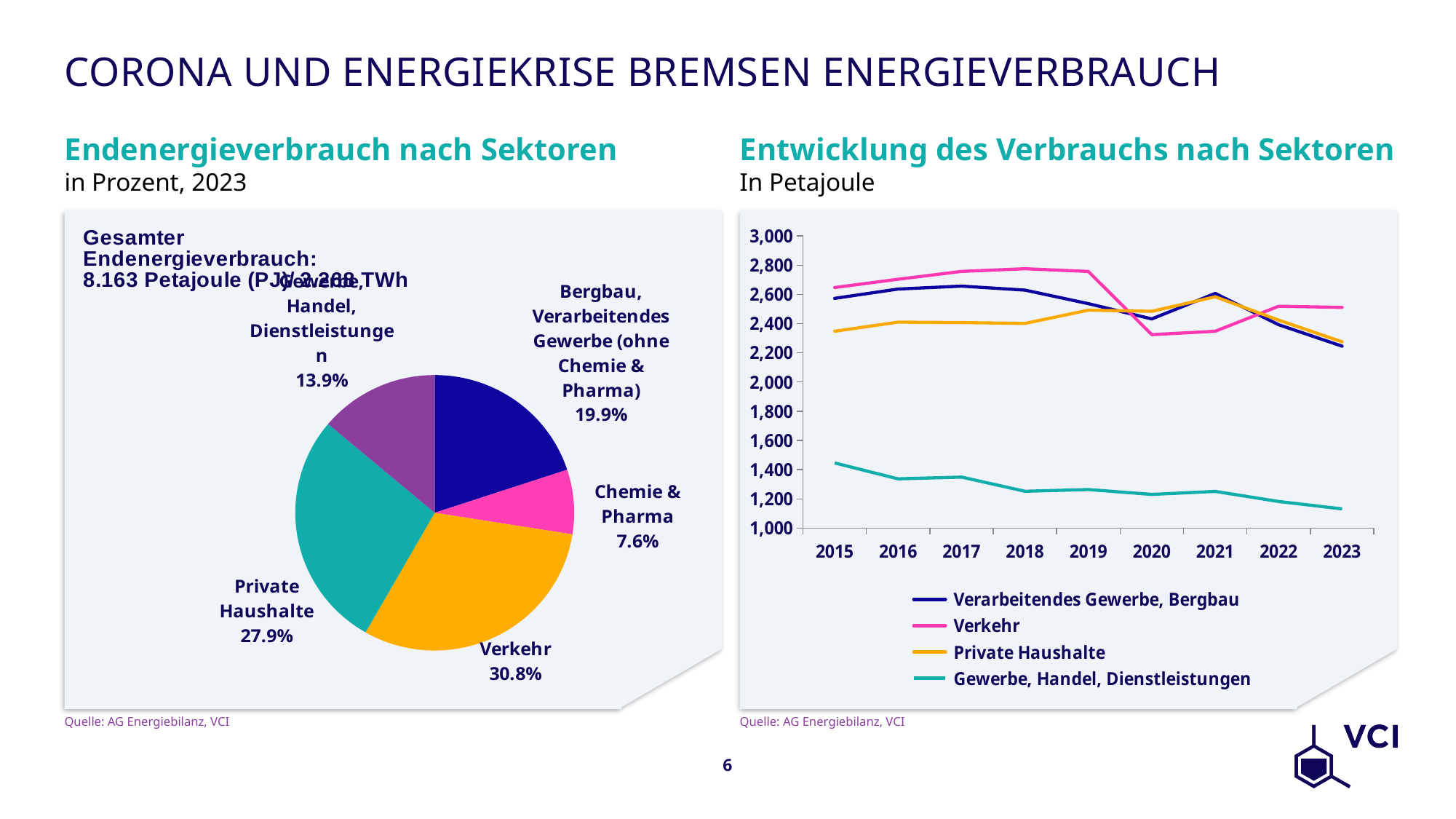
On the chart 'Entwicklung des Verbrauchs nach Sektoren', does the Gewerbe, Handel, Dienstleistungen series rise or fall from 2015 to 2023? Fall On the pie chart 'Endenergieverbrauch nach Sektoren', what share does Verkehr have? 30.8% What type of chart is 'Entwicklung des Verbrauchs nach Sektoren'? Line chart On the pie chart 'Endenergieverbrauch nach Sektoren', what share does Chemie & Pharma have? 7.6% On the pie chart 'Endenergieverbrauch nach Sektoren', which is larger: Private Haushalte or Gewerbe, Handel, Dienstleistungen? Private Haushalte How many slices does the pie chart 'Endenergieverbrauch nach Sektoren' have? 5 On the chart 'Entwicklung des Verbrauchs nach Sektoren', is the value for Verkehr in 2018 greater or less than 2,600? greater On the pie chart 'Endenergieverbrauch nach Sektoren', which sector has the largest share? Verkehr On the pie chart 'Endenergieverbrauch nach Sektoren', what is the difference in percentage points between Verkehr and Private Haushalte? 2.9 percentage points On the chart 'Entwicklung des Verbrauchs nach Sektoren', is the value for Gewerbe, Handel, Dienstleistungen in 2023 greater or less than 1,200? less On the pie chart 'Endenergieverbrauch nach Sektoren', which sector has the smallest share? Chemie & Pharma How many series does the legend of the chart 'Entwicklung des Verbrauchs nach Sektoren' list? 4